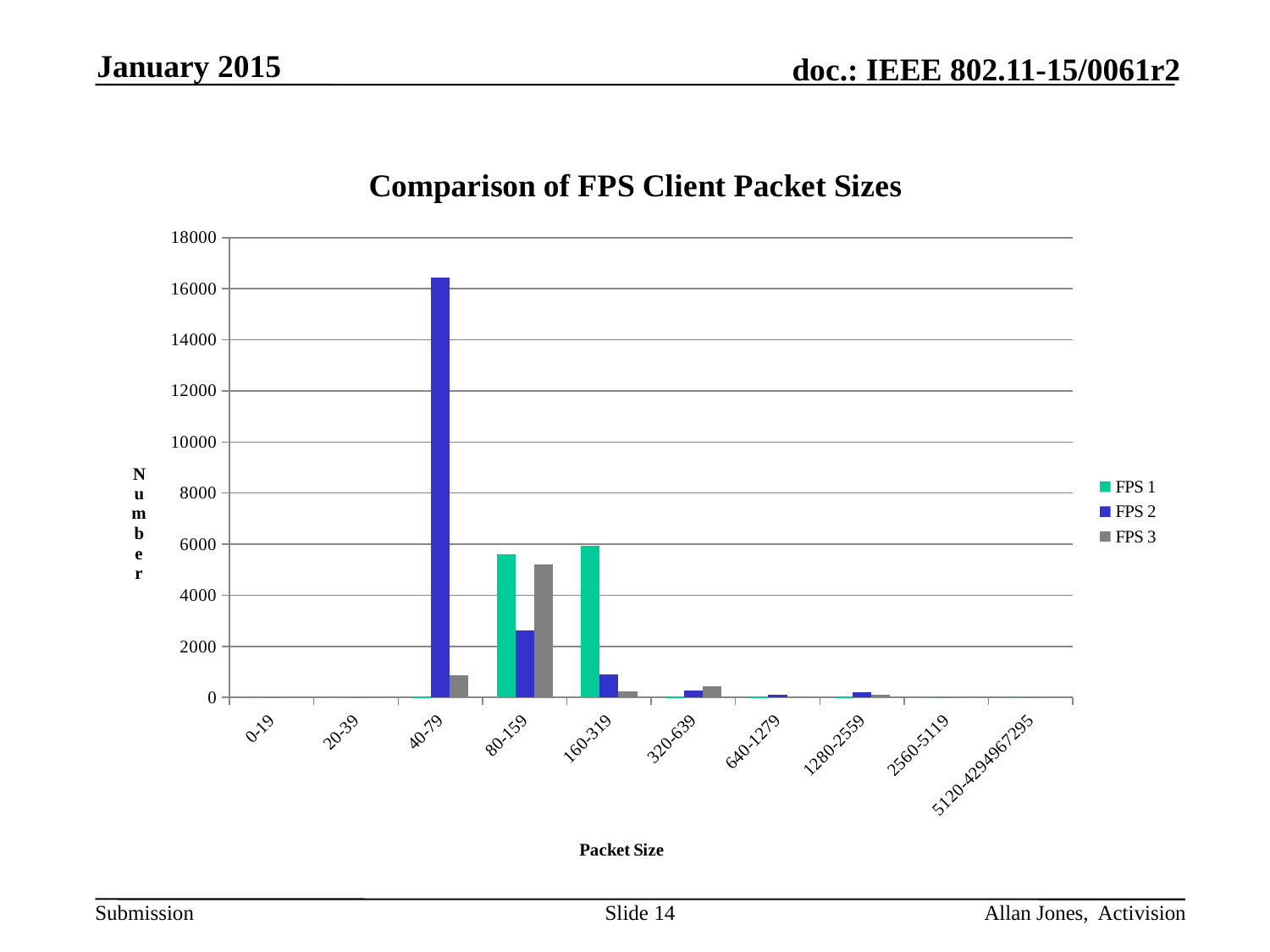
What is the title of the chart? Comparison of FPS Client Packet Sizes For which packet size category is the FPS 2 bar highest? 40-79 How many packet size categories are shown on the x axis? 10 Is the FPS 1 value for packet size 80-159 greater or less than 4000? greater How many series does the legend list? 3 What kind of chart is shown on the slide? bar chart Is the FPS 3 value for packet size 40-79 greater or less than 2000? less Which series has the tallest bar in the 40-79 packet size category? FPS 2 In the 80-159 packet size category, which is larger, the FPS 1 value or the FPS 2 value? FPS 1 Is the FPS 2 value for packet size 40-79 greater or less than 16000? greater What is the label of the x axis? Packet Size